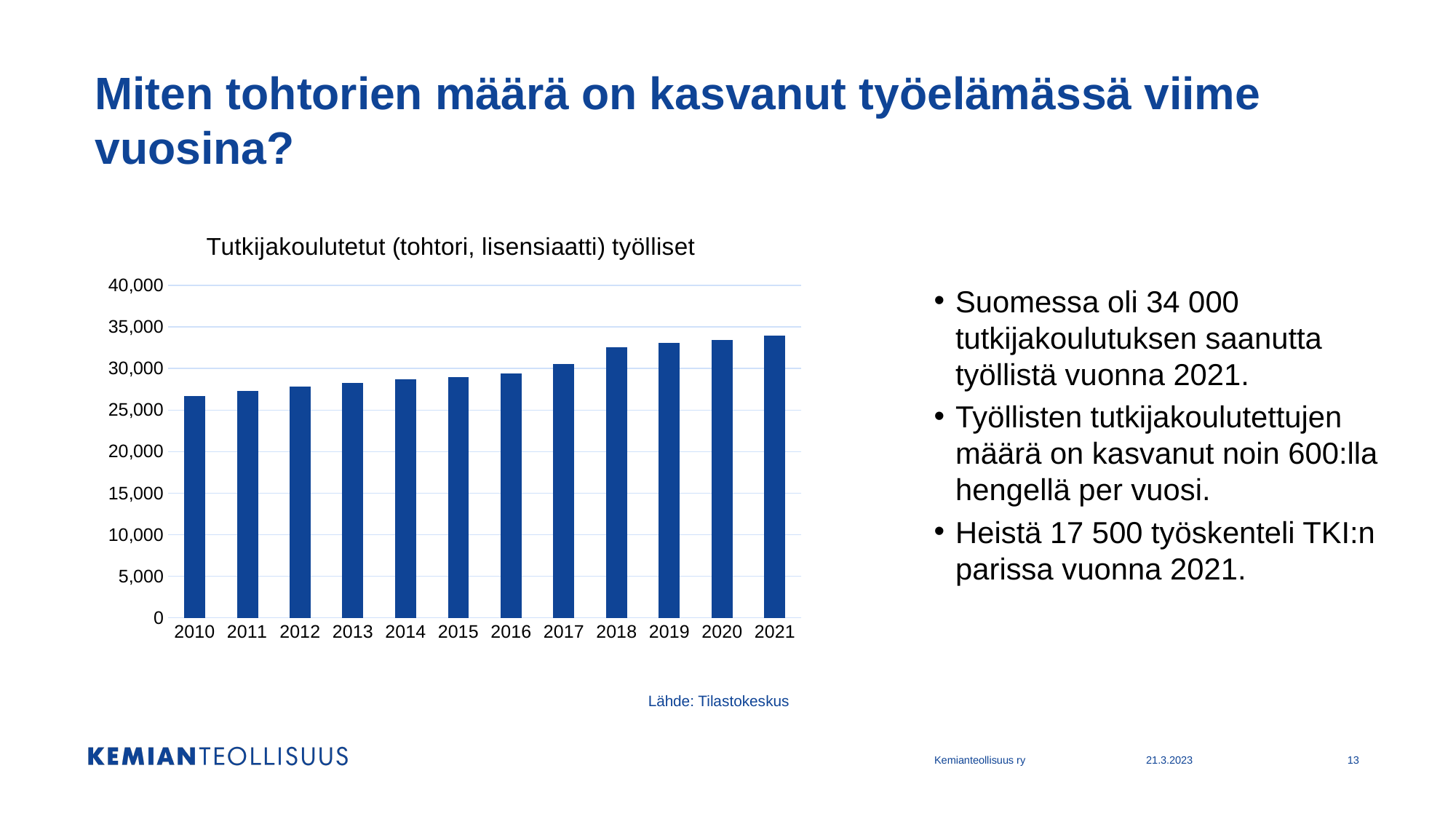
Is the value for 2010 greater or less than 30,000? less Is the value for 2020 greater or less than 35,000? less Is the value for 2018 greater or less than 30,000? greater What is the title of the chart? Tutkijakoulutetut (tohtori, lisensiaatti) työlliset What kind of chart is shown on the slide? bar chart Do the values rise or fall from 2010 to 2021? rise Which year has the lowest bar in the chart? 2010 Which year has the highest bar in the chart? 2021 Which is larger, the value for 2014 or the value for 2018? 2018 How many years are shown on the x axis of the chart? 12